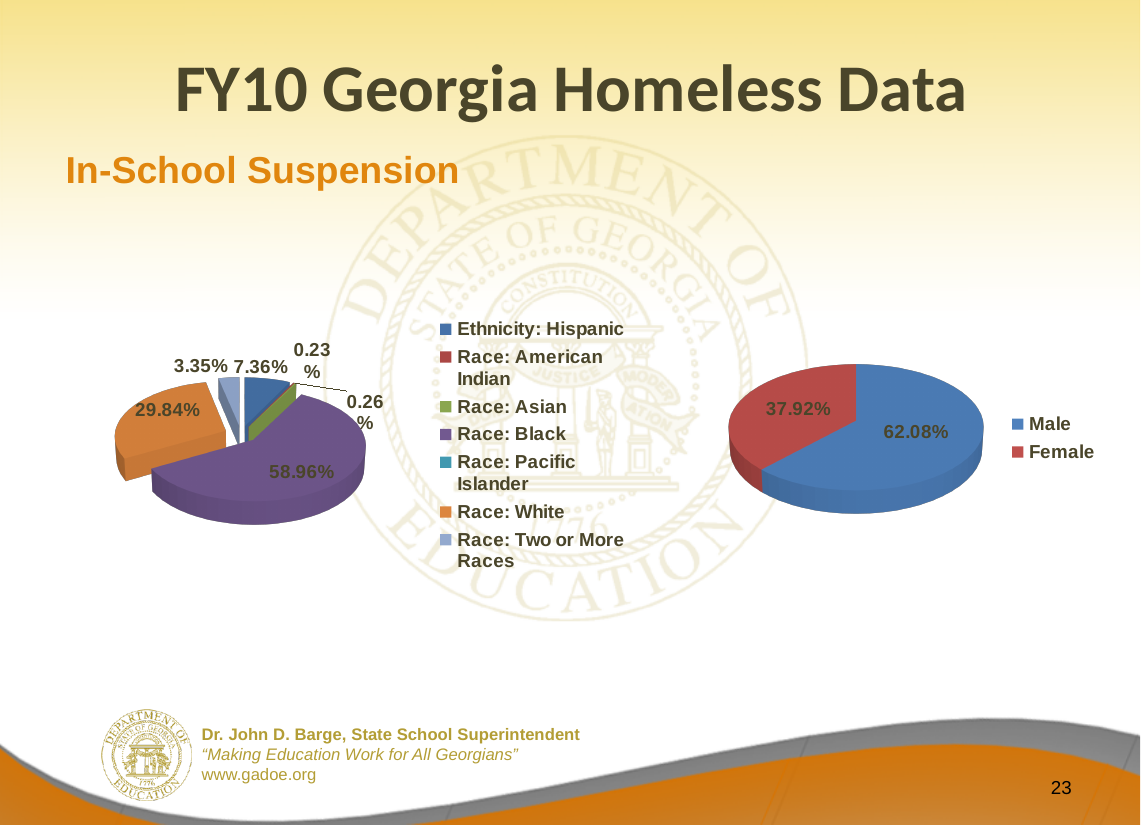
In the race/ethnicity pie chart on the left, what percentage is shown for Race: Two or More Races? 3.35% In the gender pie chart on the right, what percentage is shown for Male? 62.08% In the gender pie chart on the right, which is larger, Male or Female? Male In the race/ethnicity pie chart on the left, which category has the largest share? Race: Black In the gender pie chart on the right, what percentage is shown for Female? 37.92% What type of chart is used for the gender data on the right of the slide? Pie chart In the race/ethnicity pie chart on the left, what percentage is shown for Race: White? 29.84% In the race/ethnicity pie chart on the left, what percentage is shown for Race: Black? 58.96% How many categories does the legend of the race/ethnicity pie chart on the left list? 7 In the race/ethnicity pie chart on the left, what percentage is shown for Ethnicity: Hispanic? 7.36% In the gender pie chart on the right, what is the difference in percentage points between Male and Female? 24.16 percentage points In the race/ethnicity pie chart on the left, what is the difference in percentage points between Race: Black and Race: White? 29.12 percentage points